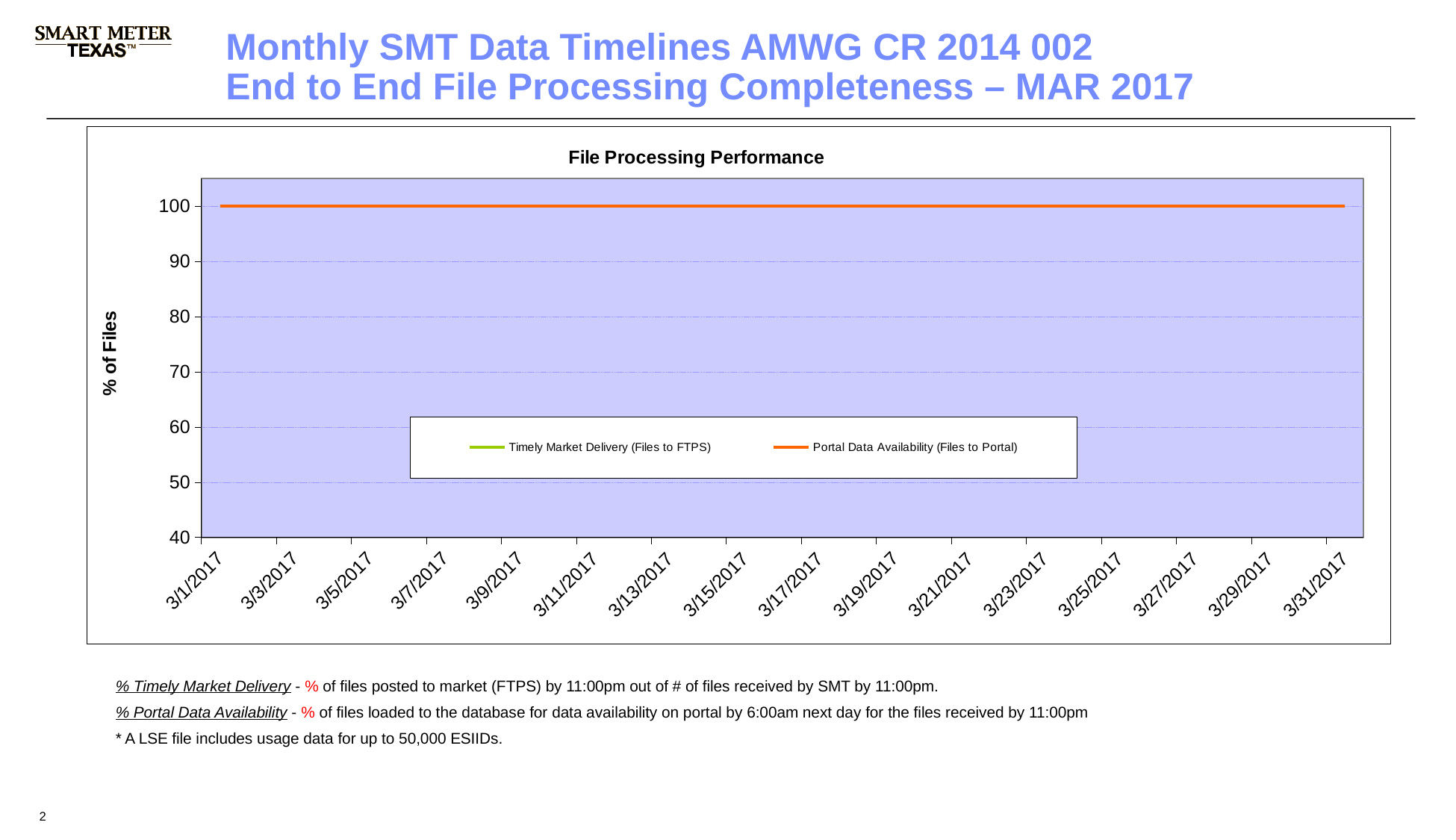
Is the value for Portal Data Availability (Files to Portal) on 3/21/2017 greater or less than 80? greater Is the value for Portal Data Availability (Files to Portal) on 3/15/2017 greater or less than 90? greater What value does the Portal Data Availability (Files to Portal) line show on 3/31/2017? 100 What kind of chart is shown on the slide? line chart Does the Portal Data Availability (Files to Portal) line rise, fall, or stay flat from 3/1/2017 to 3/31/2017? stays flat What is the title of the chart? File Processing Performance What is the lowest value shown on the y axis of the chart? 40 What is the first date shown on the x axis of the chart? 3/1/2017 What is the label on the y axis of the chart? % of Files How many series does the chart legend list? 2 What value does the Portal Data Availability (Files to Portal) line show on 3/1/2017? 100 What is the last date shown on the x axis of the chart? 3/31/2017